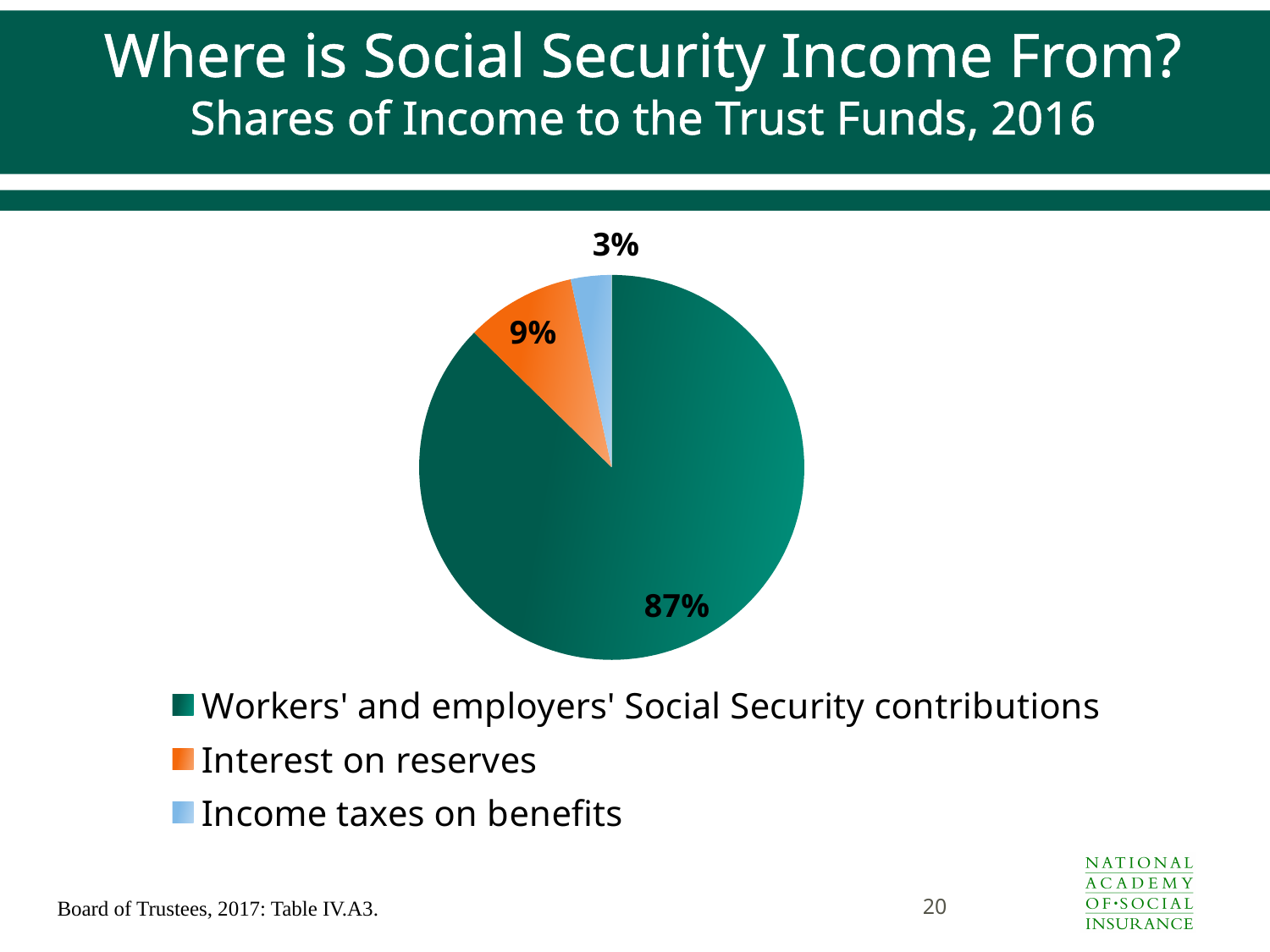
Which source provides the smallest share of income to the trust funds? Income taxes on benefits What share of income to the trust funds comes from workers' and employers' Social Security contributions? 87% What kind of chart is shown on the slide? Pie chart How many slices does the pie chart have? 3 What year do the shares of income to the trust funds refer to? 2016 What colour is the slice for interest on reserves? Orange What share of income to the trust funds comes from income taxes on benefits? 3% How many percentage points larger is the share from workers' and employers' contributions than the share from interest on reserves? 78 Which is larger: the share from interest on reserves or the share from income taxes on benefits? Interest on reserves How many percentage points larger is the share from interest on reserves than the share from income taxes on benefits? 6 What share of income to the trust funds comes from interest on reserves? 9% Which source provides the largest share of income to the trust funds? Workers' and employers' Social Security contributions